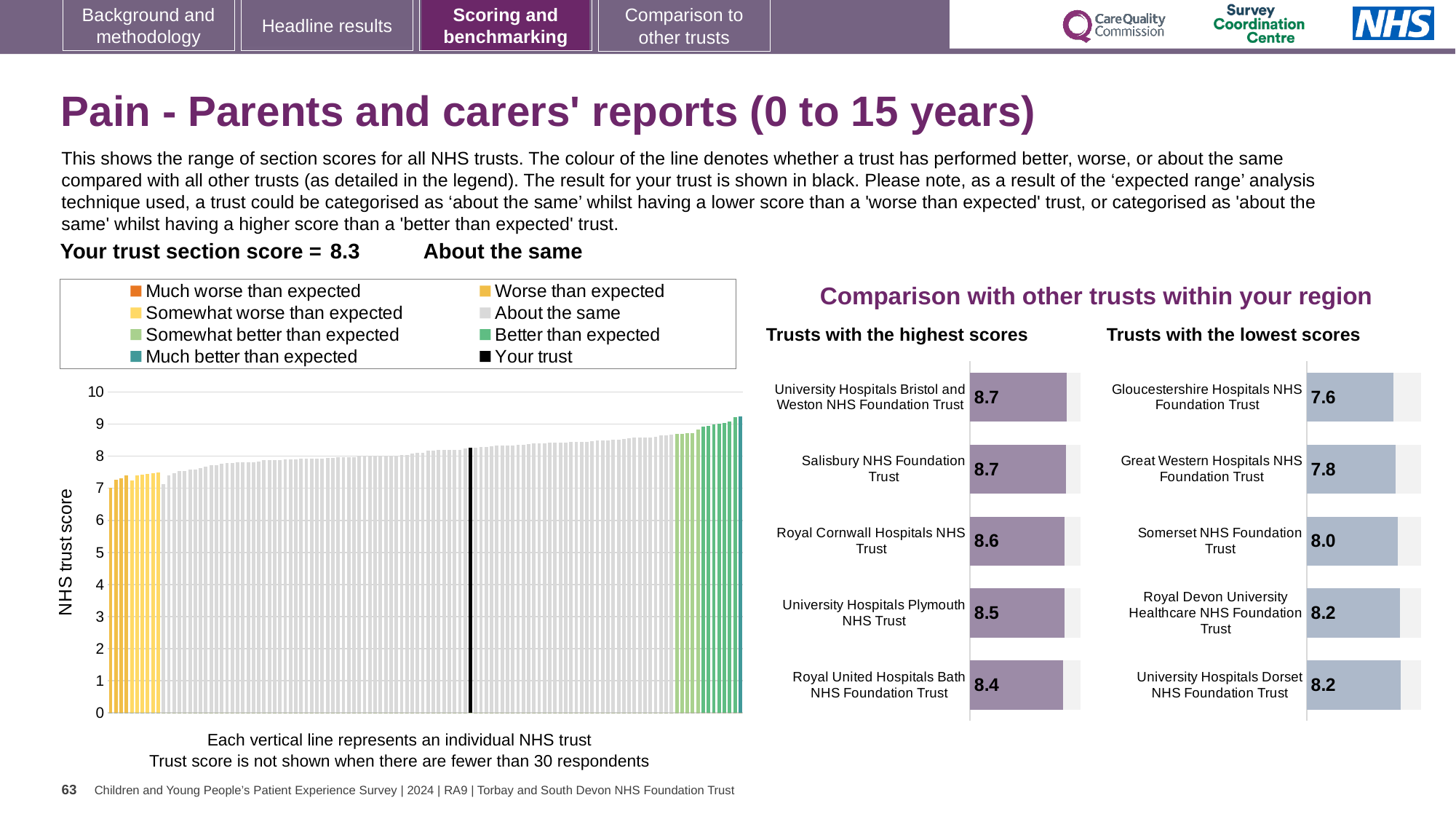
In the 'Trusts with the highest scores' chart, what is the score for Royal Cornwall Hospitals NHS Trust? 8.6 In the 'Trusts with the highest scores' chart, how many trusts are shown? 5 What kind of chart is the large chart on the left showing NHS trust scores? Bar chart In the 'Trusts with the lowest scores' chart, what is the score for Somerset NHS Foundation Trust? 8.0 In the 'Trusts with the highest scores' chart, what is the difference between the scores of University Hospitals Bristol and Weston NHS Foundation Trust and Royal United Hospitals Bath NHS Foundation Trust? 0.3 In the large chart on the left, how many entries does the legend list? 8 In the 'Trusts with the highest scores' chart, which has the larger score: Royal Cornwall Hospitals NHS Trust or University Hospitals Plymouth NHS Trust? Royal Cornwall Hospitals NHS Trust In the 'Trusts with the lowest scores' chart, which trust has the lowest score? Gloucestershire Hospitals NHS Foundation Trust In the 'Trusts with the highest scores' chart, which trust has the lowest score? Royal United Hospitals Bath NHS Foundation Trust In the 'Trusts with the lowest scores' chart, what is the difference between the scores of University Hospitals Dorset NHS Foundation Trust and Gloucestershire Hospitals NHS Foundation Trust? 0.6 In the large chart on the left, is the value for the black bar (Your trust) greater or less than 8? greater In the large chart on the left, do the trust scores rise or fall from left to right along the x axis? Rise